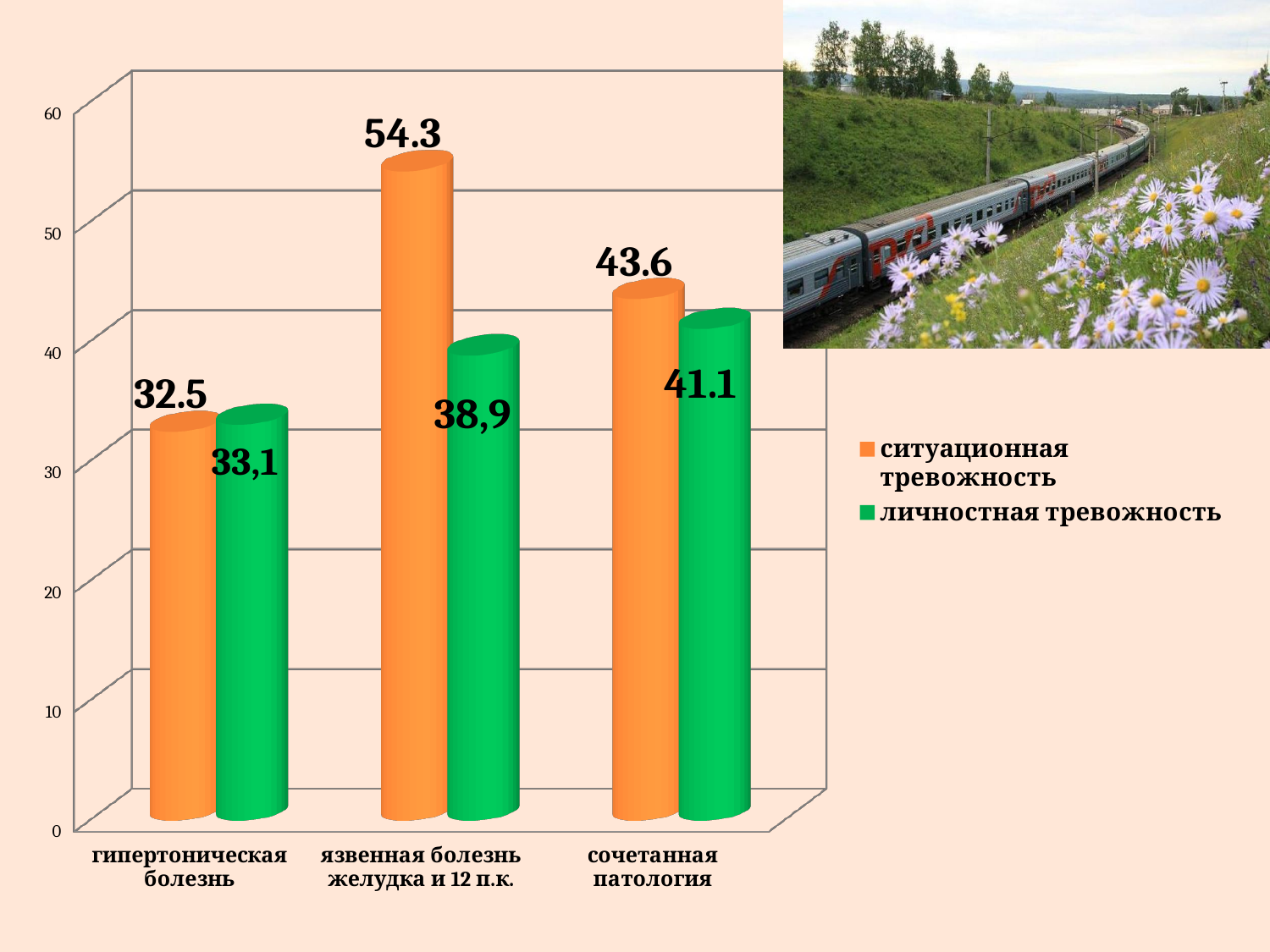
What is the value of личностная тревожность for гипертоническая болезнь? 33,1 What is the value of личностная тревожность for язвенная болезнь желудка и 12 п.к.? 38,9 What is the value of ситуационная тревожность for сочетанная патология? 43.6 What is the value of ситуационная тревожность for гипертоническая болезнь? 32.5 What is the difference between ситуационная тревожность and личностная тревожность for язвенная болезнь желудка и 12 п.к.? 15.4 Is the value of ситуационная тревожность for язвенная болезнь желудка и 12 п.к. greater or less than 50? greater For сочетанная патология, which is larger: ситуационная тревожность or личностная тревожность? ситуационная тревожность How many series does the legend list? 2 How many categories are shown on the x axis? 3 What kind of chart is shown on the slide? bar chart Which category has the lowest value for личностная тревожность? гипертоническая болезнь Which category has the highest value for ситуационная тревожность? язвенная болезнь желудка и 12 п.к.